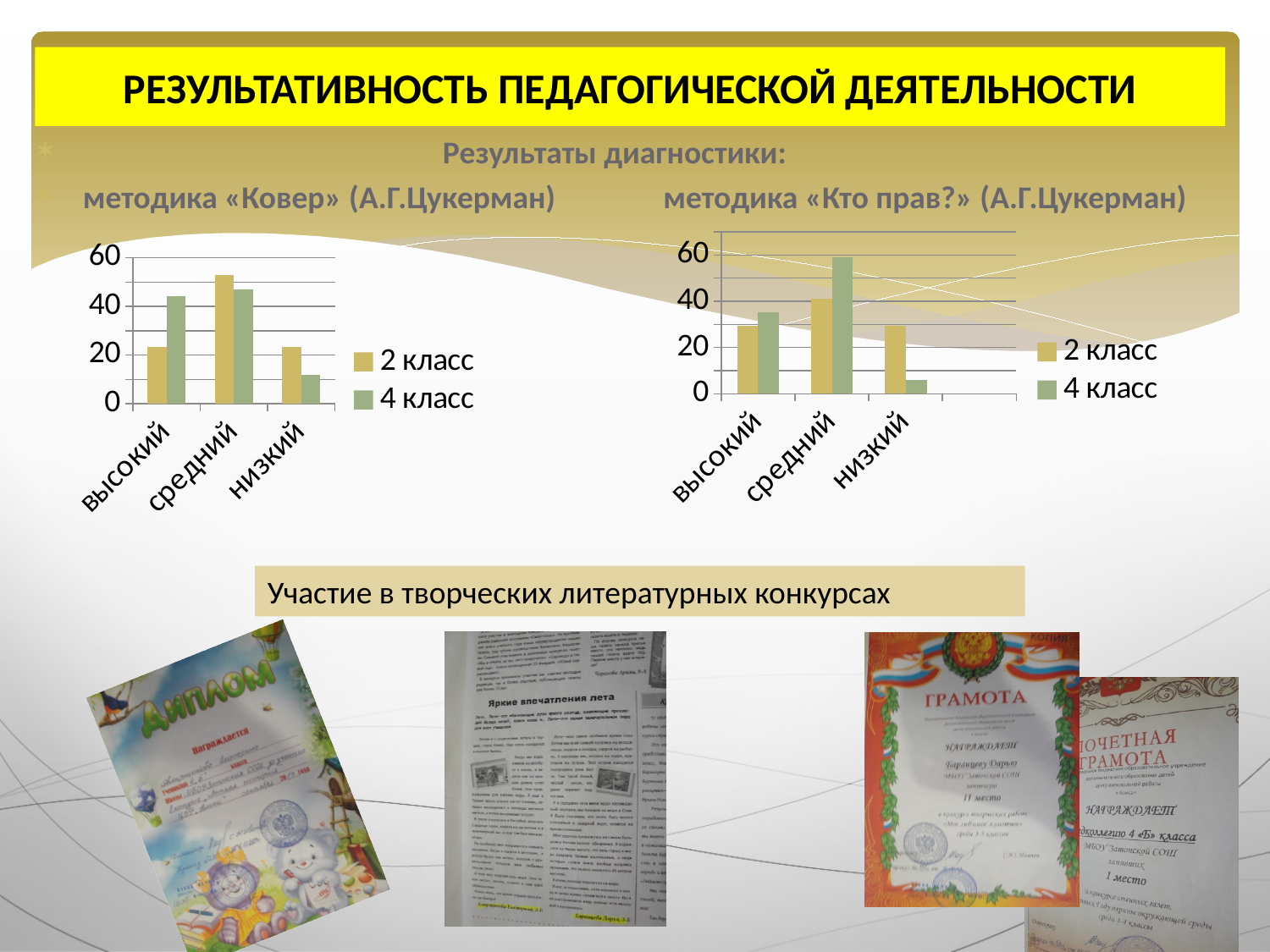
In the методика «Ковер» chart, which category has the highest value for 2 класс? средний In the методика «Ковер» chart, which category has the lowest value for 4 класс? низкий In the методика «Ковер» chart, is the value for высокий in 4 класс greater or less than 40? greater What are the two legend entries in the методика «Ковер» chart? 2 класс, 4 класс How many categories are shown on the x axis of the методика «Ковер» chart? 3 In the методика «Кто прав?» chart, which category has the highest value for 4 класс? средний How many series does the legend of the методика «Кто прав?» chart list? 2 What kind of chart is used for методика «Ковер» (А.Г.Цукерман)? bar chart In the методика «Кто прав?» chart, is the value for средний in 4 класс greater or less than 40? greater In the методика «Кто прав?» chart, for низкий, which series is larger: 2 класс or 4 класс? 2 класс In the методика «Ковер» chart, for высокий, which series is larger: 2 класс or 4 класс? 4 класс In the методика «Кто прав?» chart, is the value for низкий in 4 класс greater or less than 20? less